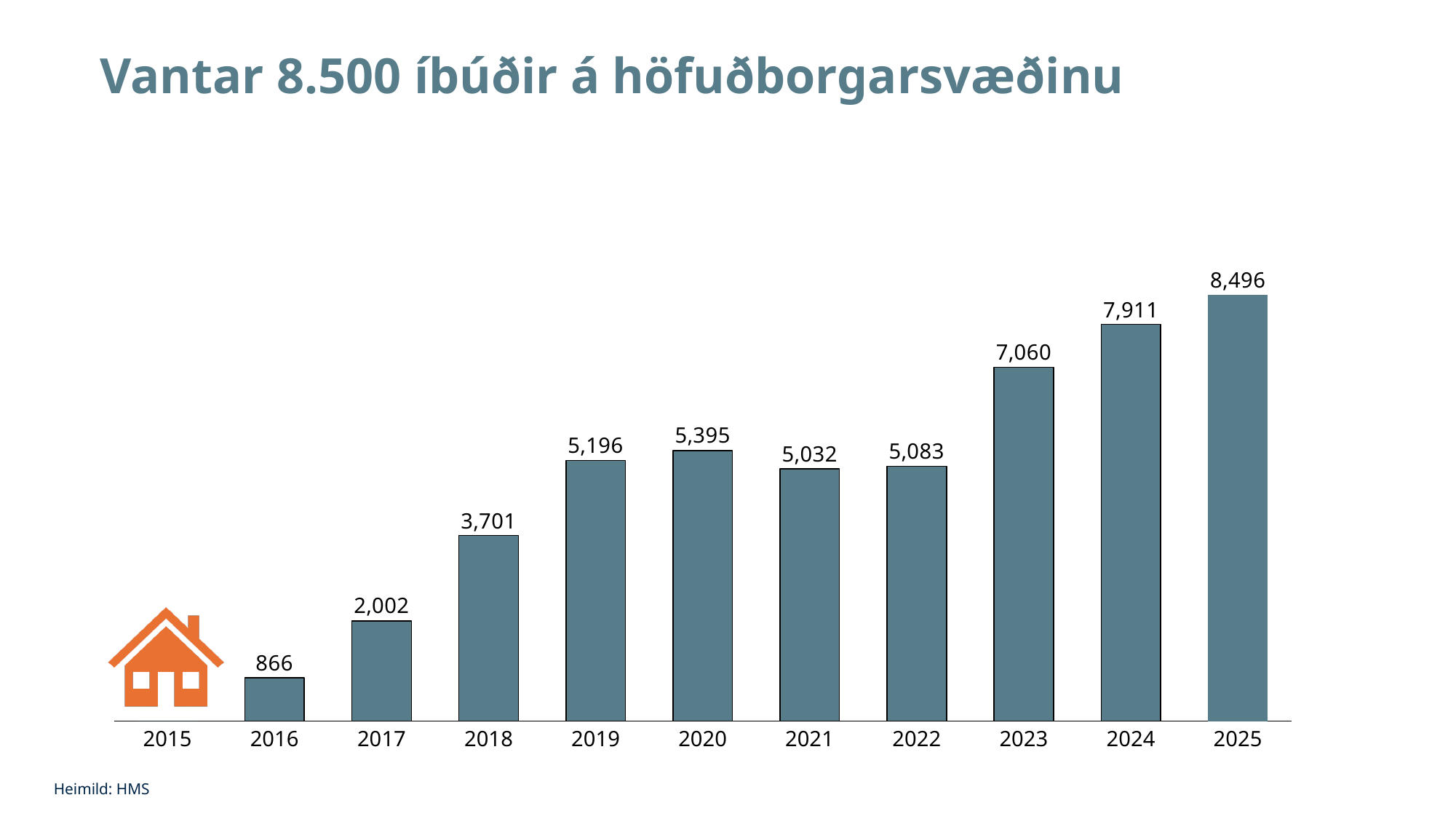
What is the title of the slide? Vantar 8.500 íbúðir á höfuðborgarsvæðinu What is the difference between the values for 2025 and 2024? 585 What is the value shown for 2021? 5,032 What kind of chart is shown on the slide? Bar chart What is the difference between the values for 2017 and 2016? 1,136 Which is larger, the value for 2020 or the value for 2021? 2020 How many bars are plotted in the chart? 10 Which year has the lowest bar? 2016 What is the value shown for 2018? 3,701 Do the values generally rise or fall from 2016 to 2025? Rise What is the value shown for 2024? 7,911 Which year has the highest value? 2025